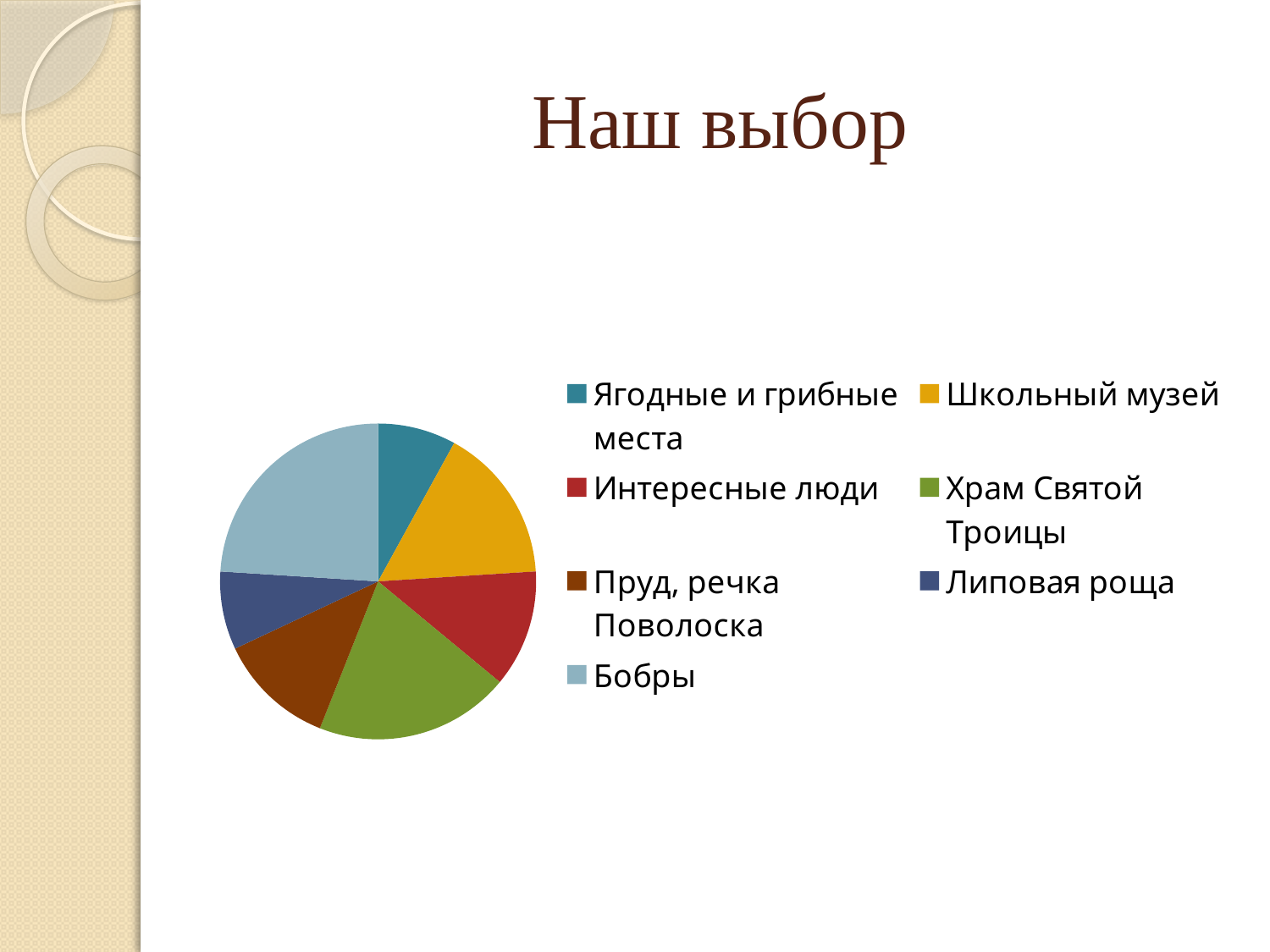
What kind of chart is shown on the slide? pie chart How many categories (slices) does the pie chart have? 7 Which category has the largest slice in the pie chart? Бобры What colour is the slice for Бобры in the pie chart? light blue Which slice is larger: Бобры or Школьный музей? Бобры What is the title of the slide with the pie chart? Наш выбор Which slice is larger: Храм Святой Троицы or Интересные люди? Храм Святой Троицы Which slice is larger: Бобры or Храм Святой Троицы? Бобры